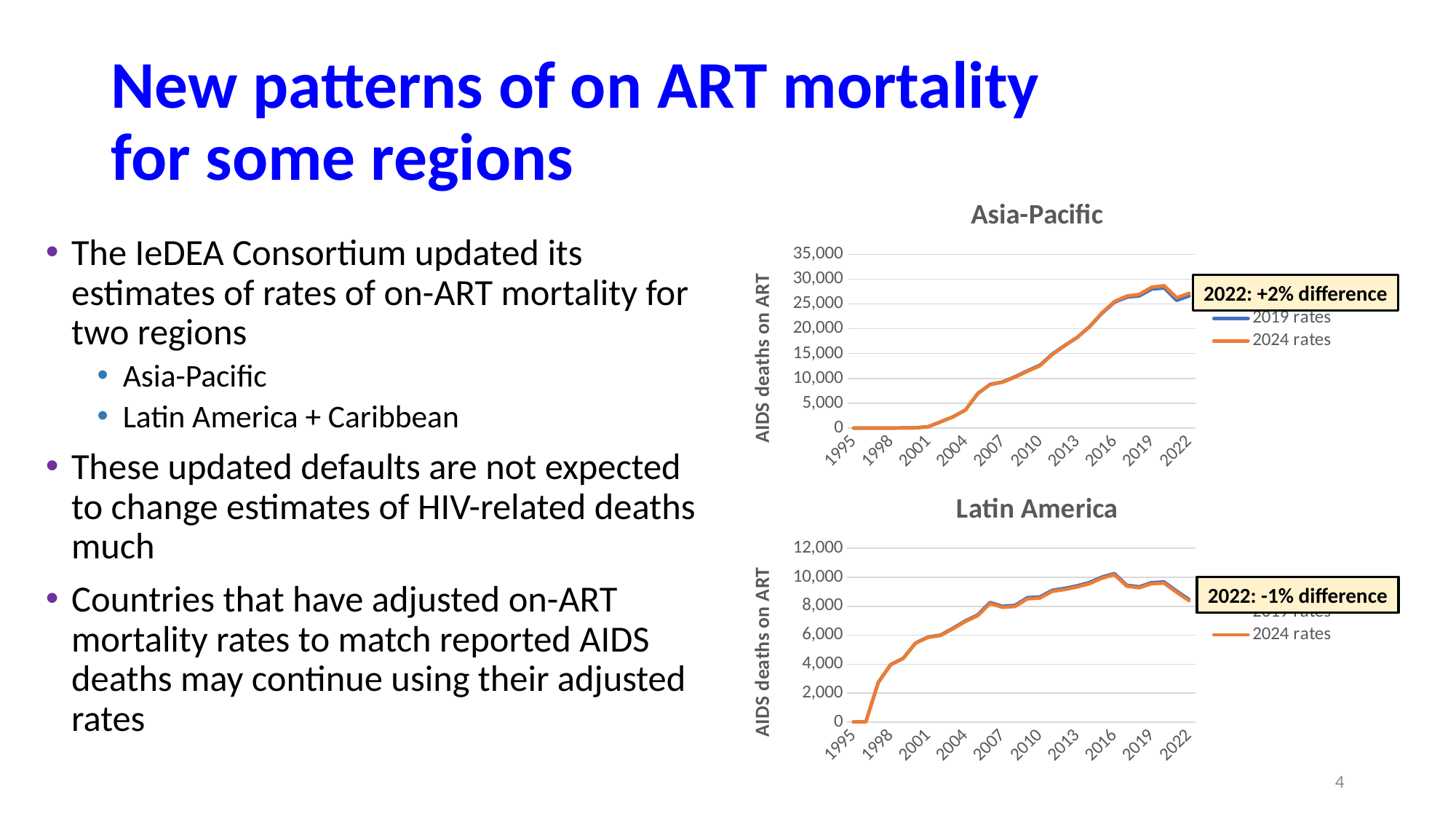
In the Asia-Pacific chart, do the values generally rise or fall from 1995 to 2019? rise In the Asia-Pacific chart, is the value for 2004 greater or less than 5,000? less What is the y-axis label on the Latin America chart? AIDS deaths on ART What kind of chart is the Asia-Pacific chart? line chart What are the two series named in the legend of the Latin America chart? 2019 rates and 2024 rates In the Latin America chart, is the value for 2013 greater or less than 8,000? greater In the Latin America chart, do the values rise or fall from 2016 to 2022? fall In the Asia-Pacific chart, is the value for 2010 greater or less than 10,000? greater In the Asia-Pacific chart, what difference is annotated for 2022? +2% difference How many series does the legend of the Asia-Pacific chart list? 2 In the Latin America chart, what difference is annotated for 2022? -1% difference